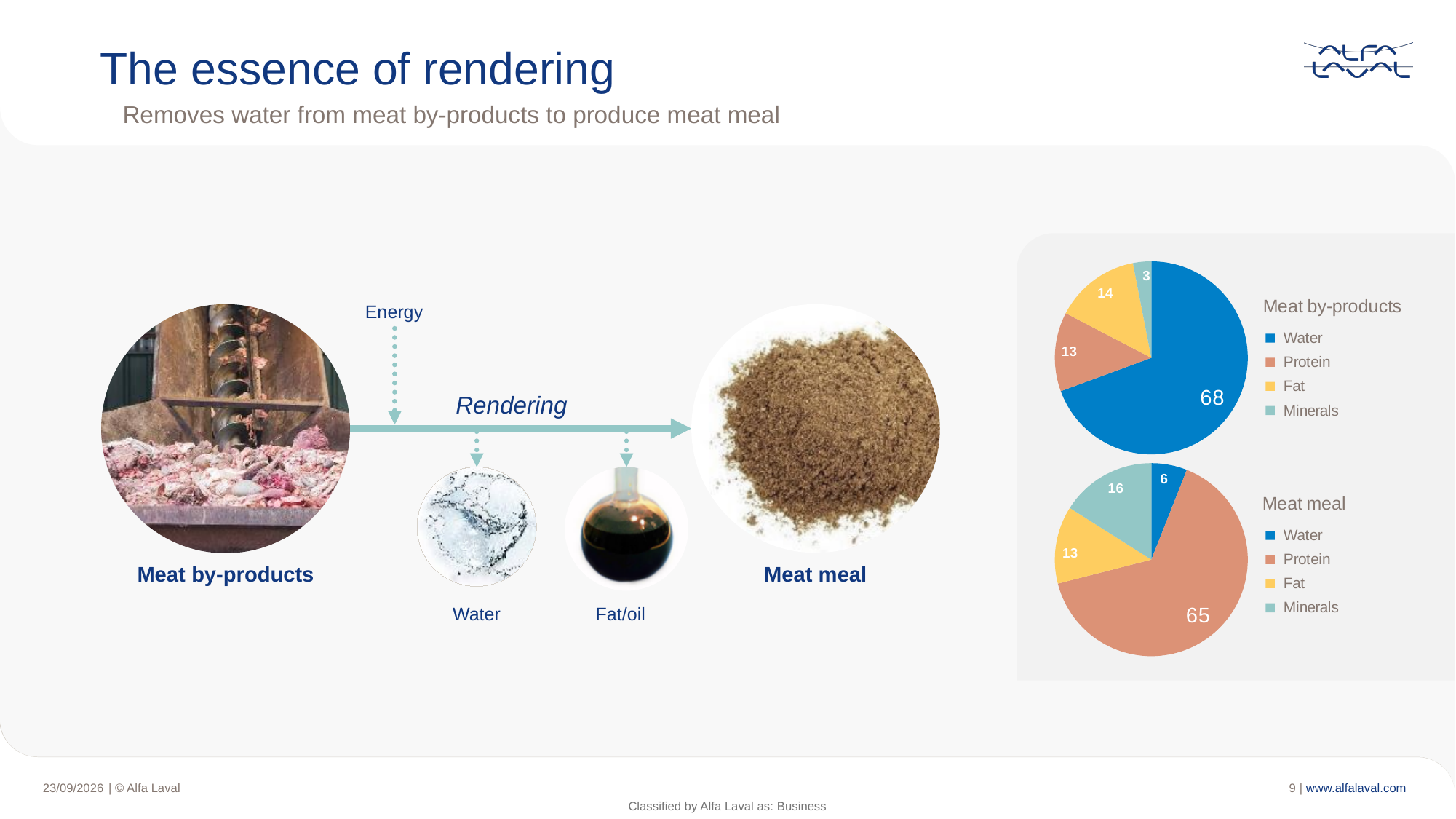
In the Meat meal chart, which colour represents Protein? Orange What type of chart is the Meat by-products chart? Pie chart In the Meat meal chart, what is the value for Minerals? 16 How many categories does the Meat meal chart show? 4 In the Meat by-products chart, what is the value for Fat? 14 In the Meat by-products chart, what is the total of the Fat and Minerals values? 17 In the Meat meal chart, what is the value for Protein? 65 In the Meat meal chart, which category has the smallest slice? Water In the Meat meal chart, which is larger, Fat or Minerals? Minerals In the Meat by-products chart, which category has the largest slice? Water In the Meat by-products chart, what is the difference between the Water and Protein values? 55 In the Meat by-products chart, what is the value for Water? 68